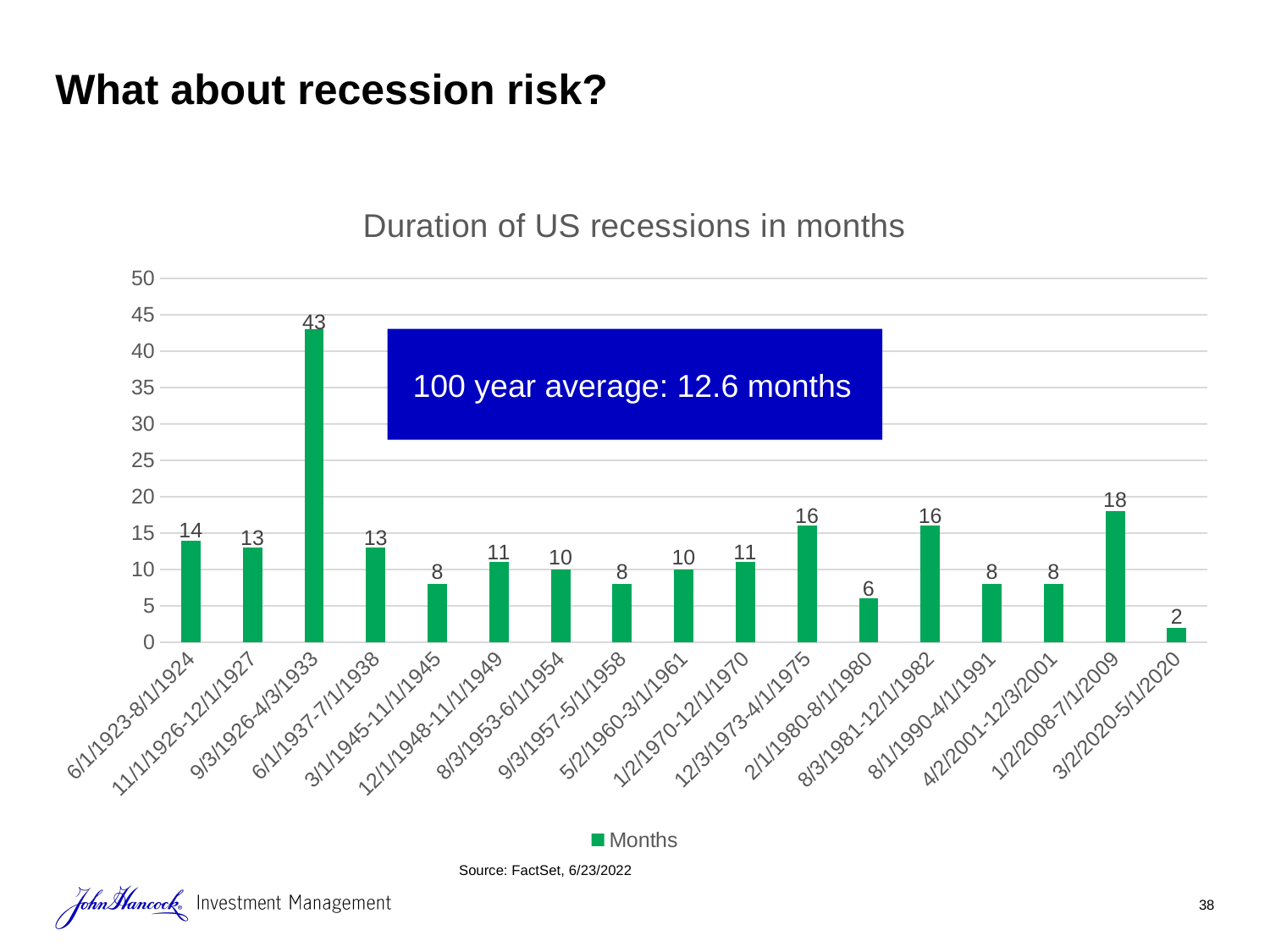
What is the duration in months for the 9/3/1926-4/3/1933 recession? 43 What kind of chart is shown on the slide? bar chart Which recession has the shortest duration? 3/2/2020-5/1/2020 How many recessions are shown on the chart? 17 What is the duration in months for the 1/2/2008-7/1/2009 recession? 18 What 100 year average is stated in the box on the chart? 12.6 months How many series does the legend list? 1 Which recession has the longest duration? 9/3/1926-4/3/1933 What is the difference in months between the 9/3/1926-4/3/1933 recession and the 1/2/2008-7/1/2009 recession? 25 What is the duration in months for the 2/1/1980-8/1/1980 recession? 6 Which recession lasted longer, 12/3/1973-4/1/1975 or 6/1/1923-8/1/1924? 12/3/1973-4/1/1975 Is the value for the 3/2/2020-5/1/2020 recession greater or less than 5? less